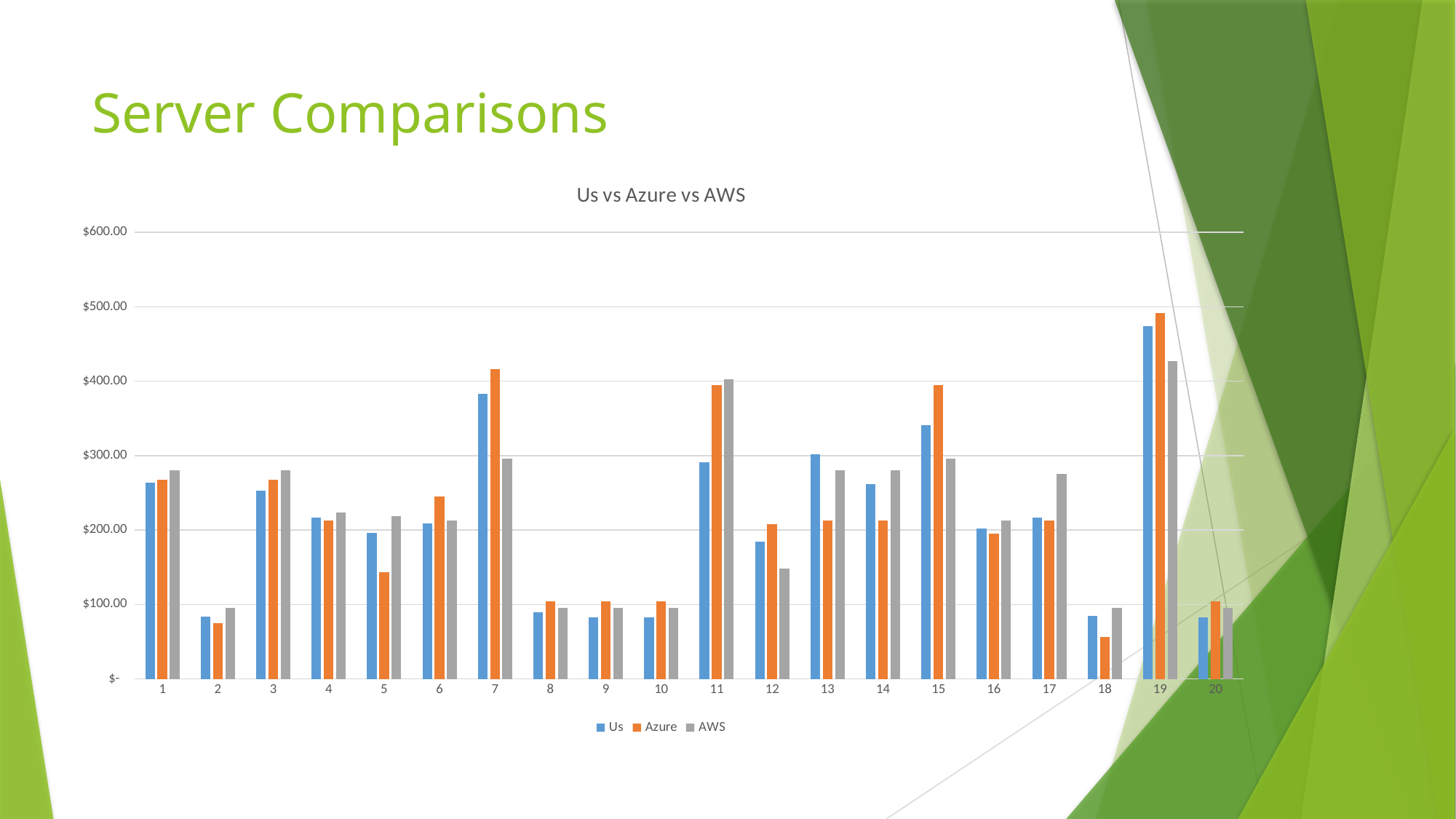
For category 5, which is larger: the Us value or the Azure value? Us How many categories are shown along the x axis? 20 For which category is the Azure value highest? 19 What kind of chart is shown on the slide? bar chart Is the Azure value for category 18 greater or less than $100.00? less For category 7, which is larger: the Azure value or the AWS value? Azure How many series does the legend list? 3 For which category is the Us value highest? 19 Is the AWS value for category 12 greater or less than $200.00? less Is the Azure value for category 7 greater or less than $400.00? greater Which series is shown in orange? Azure What is the title of the chart? Us vs Azure vs AWS